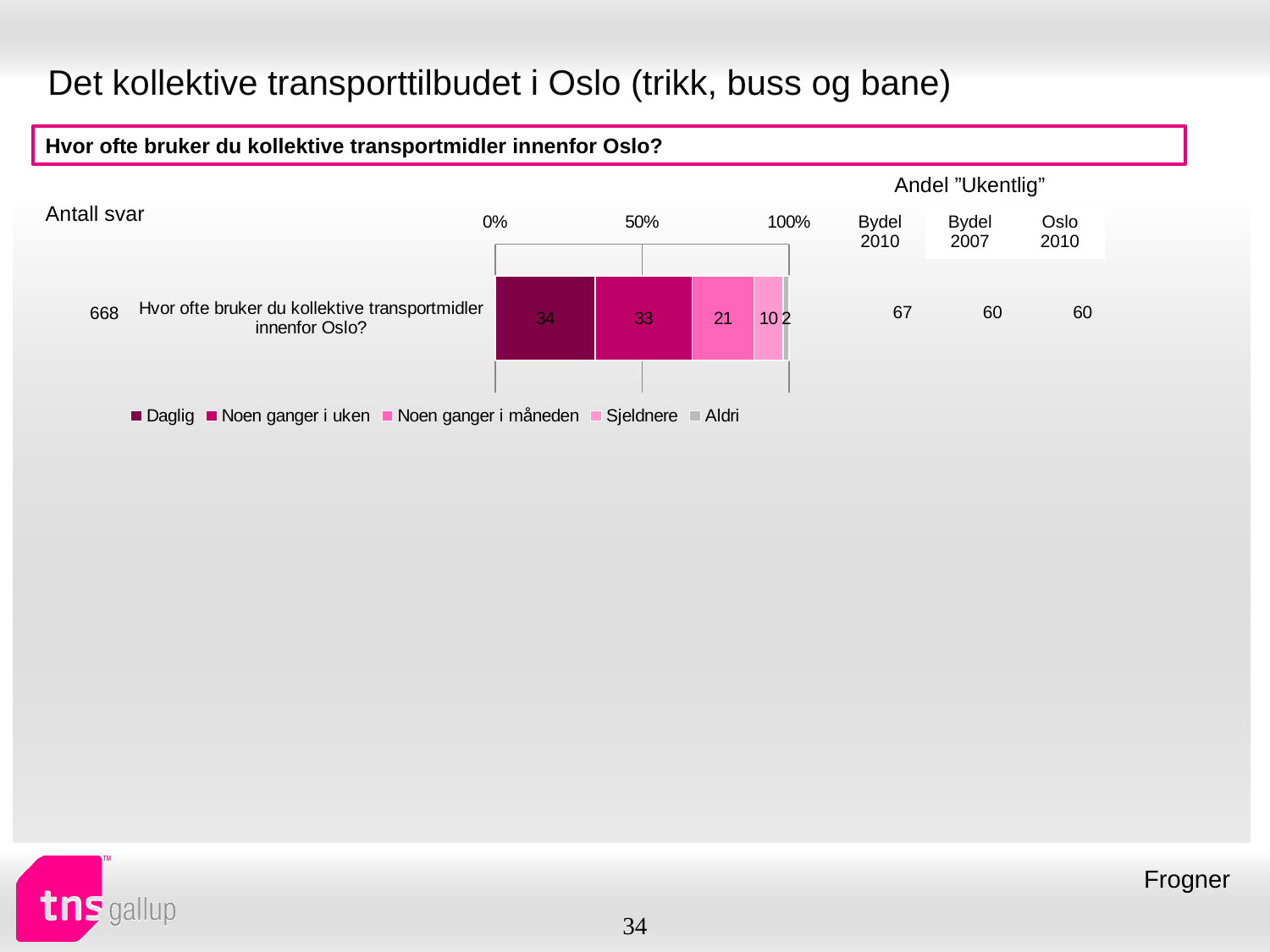
What is the difference between the "Noen ganger i uken" and "Sjeldnere" values? 23 How many categories (bars) does the chart show? 1 What is the value for "Noen ganger i uken" in the bar? 33 What is the total of all segments in the stacked bar? 100 What is the value for "Daglig" in the bar? 34 What kind of chart is shown on the slide? Stacked bar chart What is the value for "Noen ganger i måneden" in the bar? 21 Which series has the smallest segment in the bar? Aldri What is the value for "Sjeldnere" in the bar? 10 Which series has the largest segment in the bar? Daglig How many series does the chart legend list? 5 What is the value for "Aldri" in the bar? 2